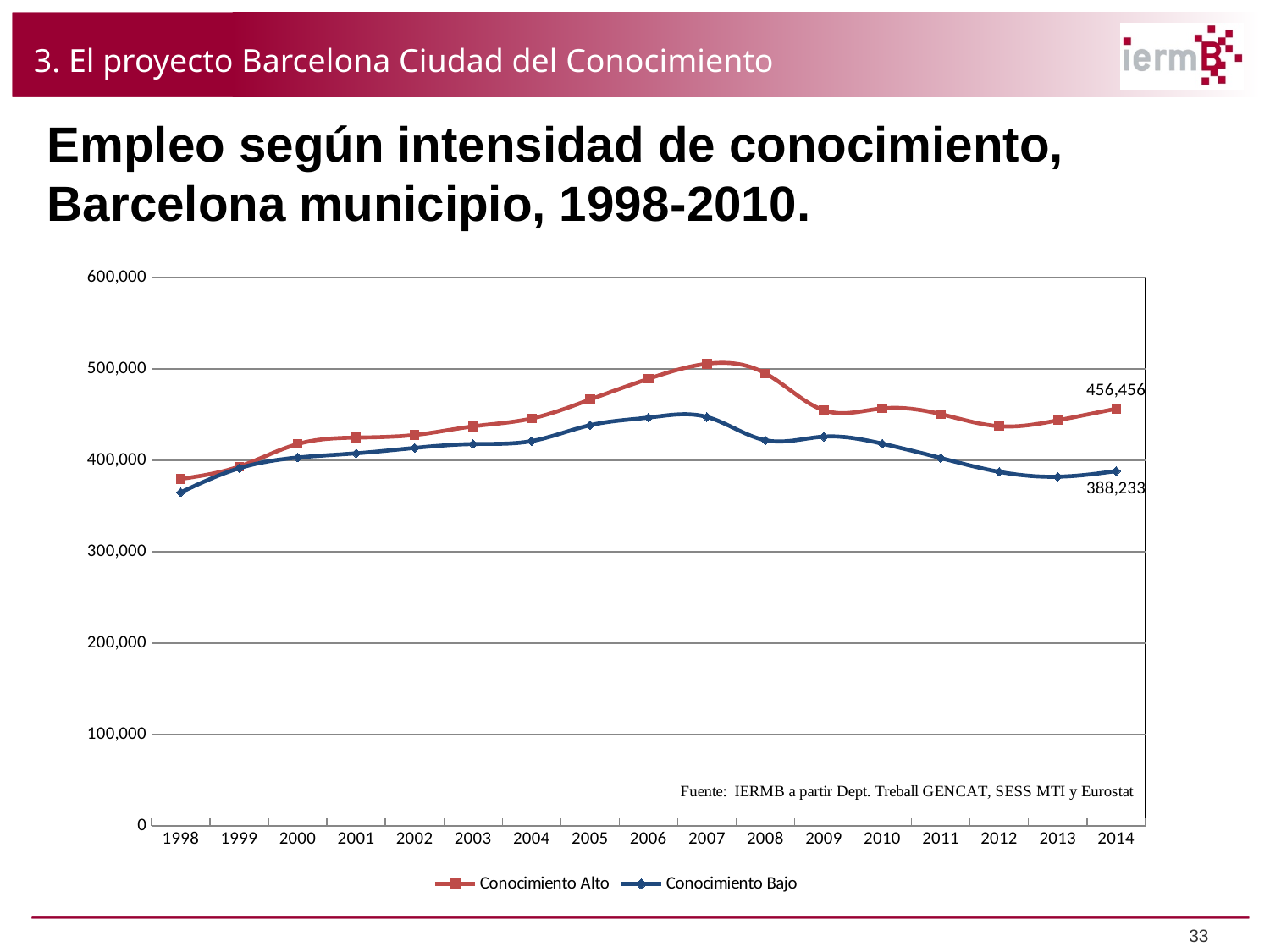
Does the Conocimiento Alto series rise or fall between 2007 and 2009? fall In which year does Conocimiento Bajo have its lowest value? 1998 In 2014, which series has the larger value, Conocimiento Alto or Conocimiento Bajo? Conocimiento Alto Is the value for Conocimiento Bajo in 2007 greater or less than 500,000? less Is the value for Conocimiento Alto in 2005 greater or less than 400,000? greater How many series does the legend list? 2 How many years are shown on the x axis of the chart? 17 What kind of chart is shown on the slide? line chart What is the difference between Conocimiento Alto and Conocimiento Bajo in 2014? 68,223 What is the value for Conocimiento Bajo in 2014? 388,233 In which year does Conocimiento Alto reach its highest value? 2007 What is the value for Conocimiento Alto in 2014? 456,456